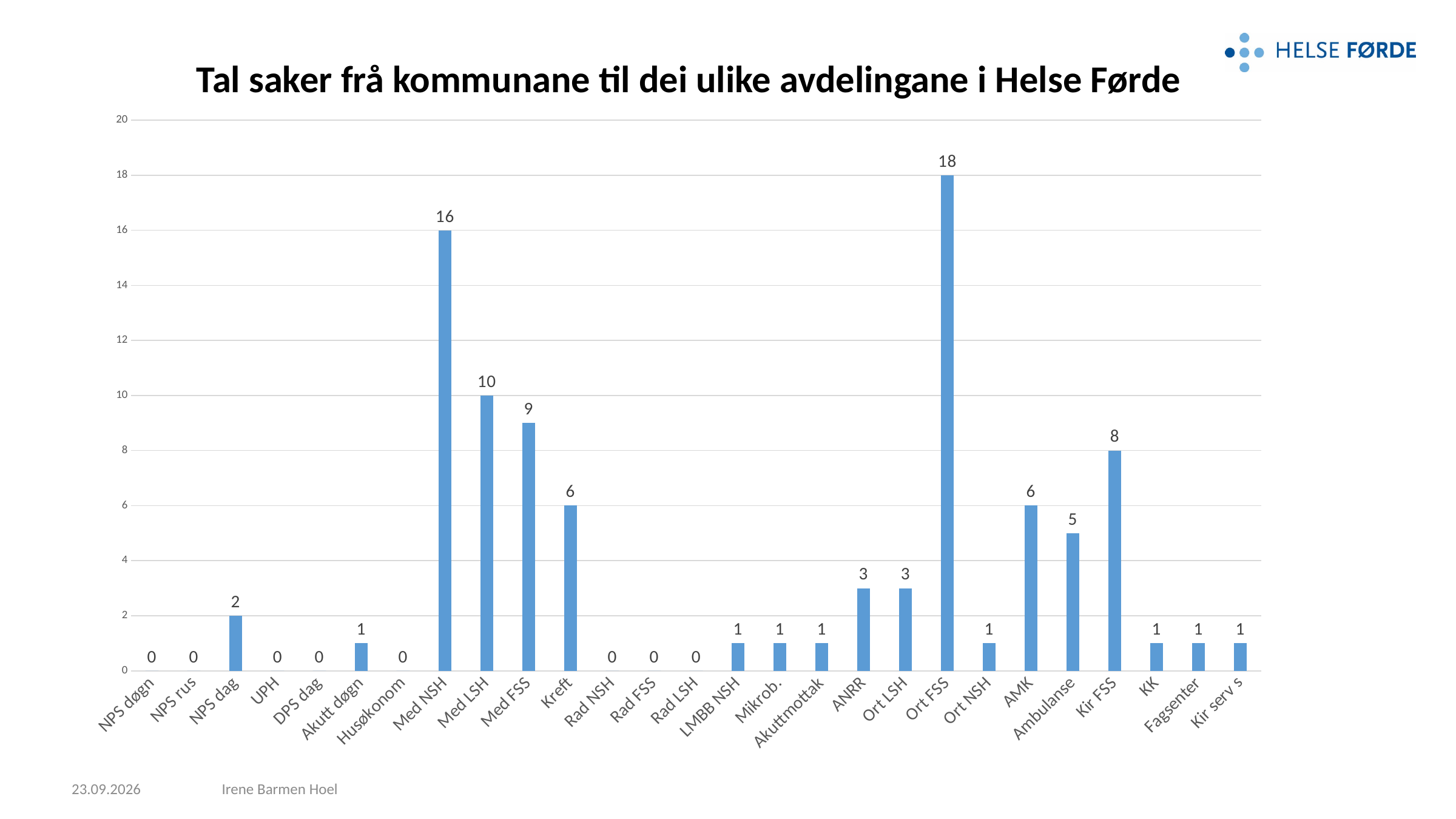
What is the value for Kir FSS? 8 Which is larger, the value for Kir FSS or the value for Med FSS? Med FSS How many categories are shown on the x axis? 27 What is the difference between the values for Ort FSS and Med NSH? 2 What is the difference between the values for Med LSH and Med FSS? 1 What is the value for Ambulanse? 5 Which category has the highest value? Ort FSS What is the value for Med NSH? 16 What is the value for Ort FSS? 18 What kind of chart is this? Bar chart What is the title of the chart? Tal saker frå kommunane til dei ulike avdelingane i Helse Førde Which is larger, the value for Kreft or the value for AMK? They are equal (6)